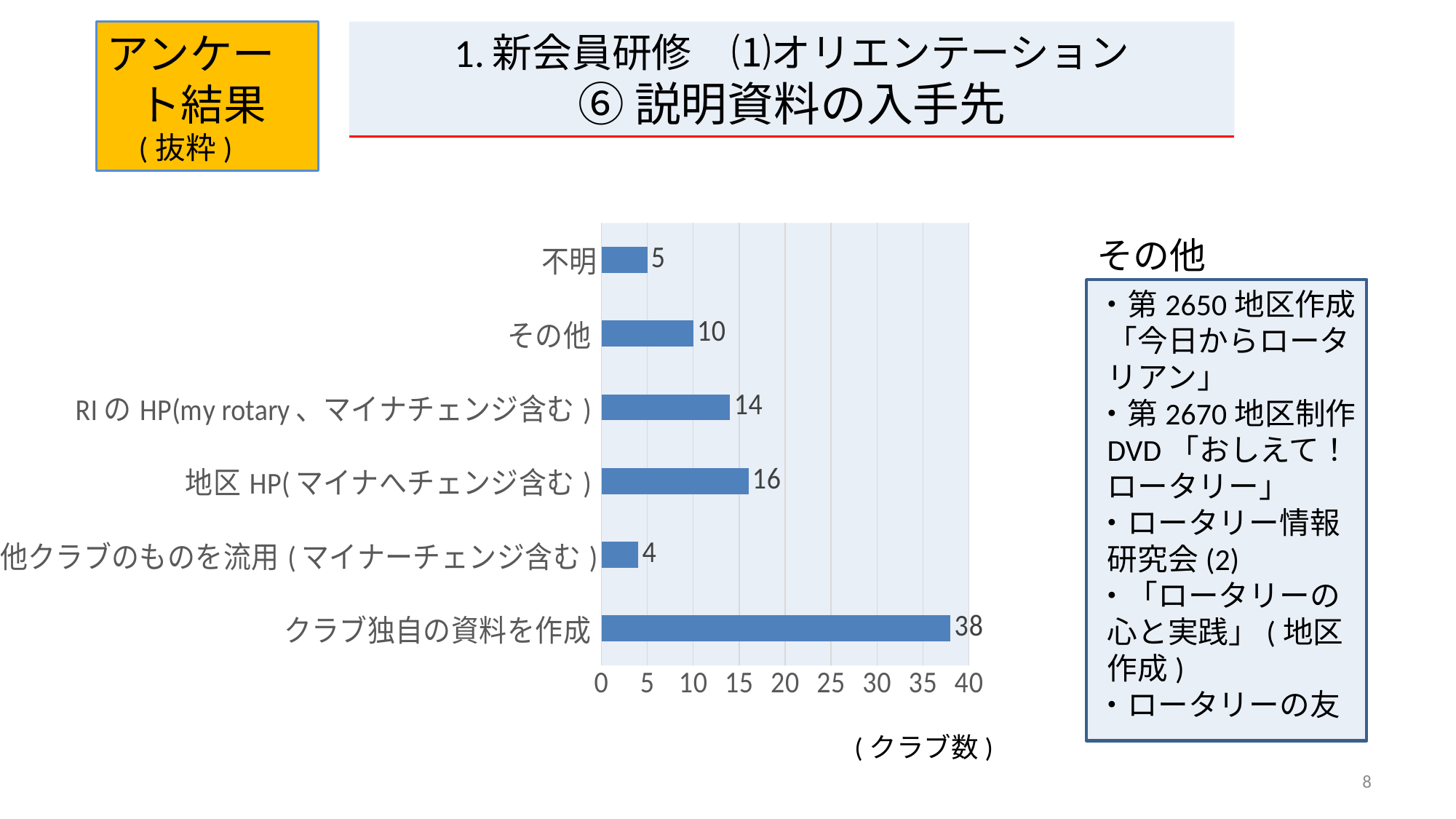
Which is larger, その他 or 不明? その他 What is the difference between クラブ独自の資料を作成 and 地区HP(マイナへチェンジ含む)? 22 What kind of chart is shown on the slide? bar chart How many categories are shown in the chart? 6 Is the value for クラブ独自の資料を作成 greater or less than 35? greater What unit is indicated below the chart's axis? (クラブ数) Which category has the highest value? クラブ独自の資料を作成 What is the value for クラブ独自の資料を作成? 38 What is the value for 不明? 5 Which category has the lowest value? 他クラブのものを流用(マイナーチェンジ含む) What is the value for 地区HP(マイナへチェンジ含む)? 16 What is the value for RIのHP(my rotary、マイナチェンジ含む)? 14